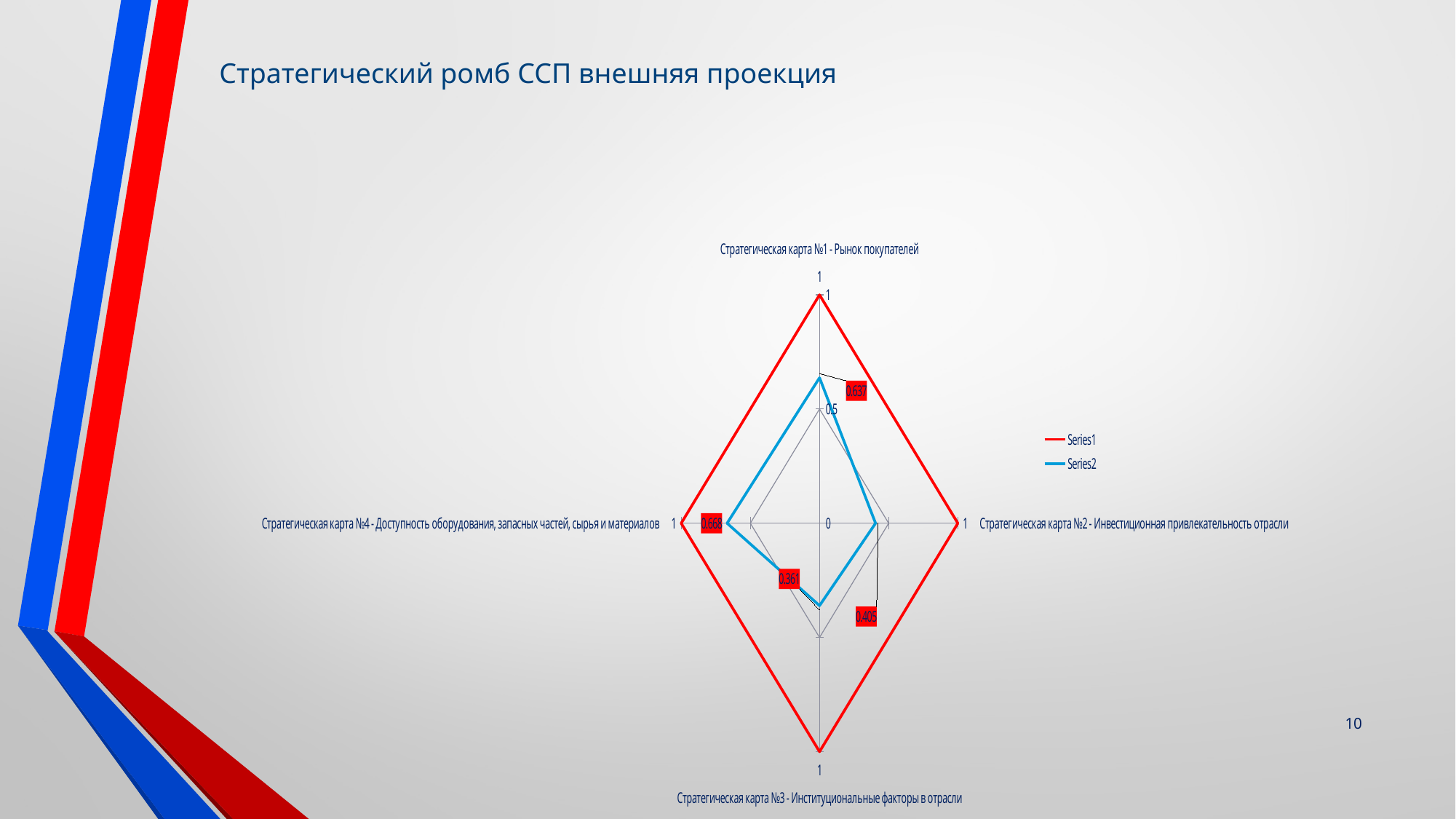
What kind of chart is shown on the slide? Radar chart How many series does the legend list? 2 What is the Series2 value for Стратегическая карта №2 - Инвестиционная привлекательность отрасли? 0.405 What is the Series2 value for Стратегическая карта №4 - Доступность оборудования, запасных частей, сырья и материалов? 0.668 What is the Series2 value for Стратегическая карта №1 - Рынок покупателей? 0.637 What is the title of the slide containing the chart? Стратегический ромб ССП внешняя проекция How many axes (categories) does the radar chart have? 4 What is the difference between the Series2 values for Стратегическая карта №4 and Стратегическая карта №3? 0.307 What is the Series2 value for Стратегическая карта №3 - Институциональные факторы в отрасли? 0.361 On which axis does Series2 have its highest value? Стратегическая карта №4 - Доступность оборудования, запасных частей, сырья и материалов On which axis does Series2 have its lowest value? Стратегическая карта №3 - Институциональные факторы в отрасли What is the Series1 value for Стратегическая карта №1 - Рынок покупателей? 1